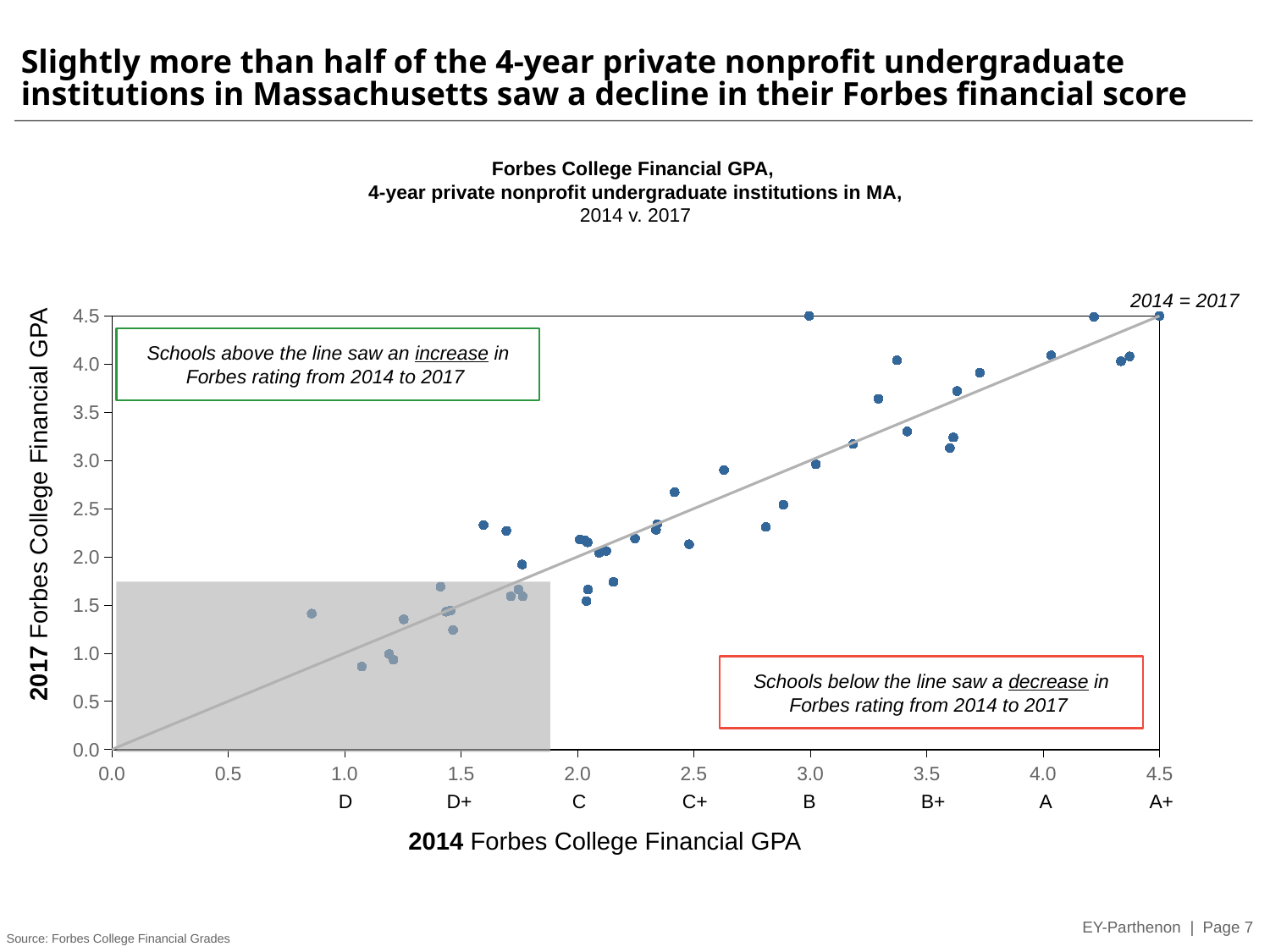
Is the lowest 2017 Forbes College Financial GPA plotted greater or less than 1.0? less Which letter grade corresponds to a 2014 Forbes College Financial GPA of 4.5 on the x axis? A+ What kind of chart is shown on the slide? Scatter plot Is the lowest 2014 Forbes College Financial GPA plotted greater or less than 1.0? less What does the diagonal grey reference line on the chart represent, according to its label? 2014 = 2017 Is the highest 2017 Forbes College Financial GPA plotted greater or less than 4.0? greater As the 2014 Forbes College Financial GPA increases along the x axis, do the plotted 2017 GPA values generally rise or fall? Rise